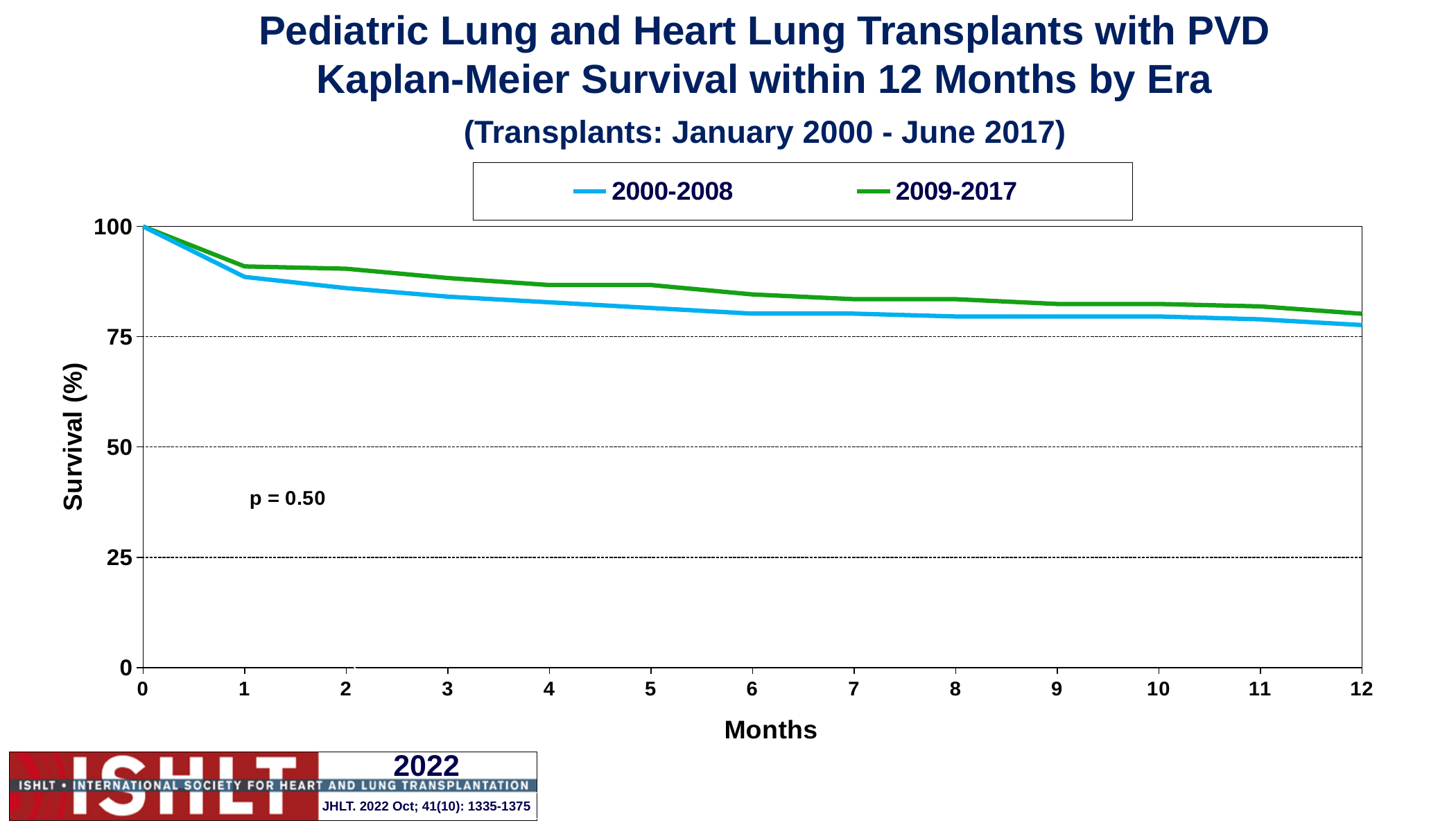
At month 12, which series has the lower survival, 2000-2008 or 2009-2017? 2000-2008 At month 6, which series has the higher survival, 2000-2008 or 2009-2017? 2009-2017 What is the survival value for the 2000-2008 series at month 0? 100 Do the survival values rise or fall as months increase along the x axis? fall How many series does the legend list? 2 What is the label of the y axis? Survival (%) What p-value is printed on the chart? p = 0.50 Is the survival value for the 2000-2008 series at month 12 greater or less than 75? greater What kind of chart is shown on the slide? line chart Is the survival value for the 2009-2017 series at month 1 greater or less than 100? less What is the survival value for the 2009-2017 series at month 0? 100 Is the survival value for the 2009-2017 series at month 6 greater or less than 75? greater